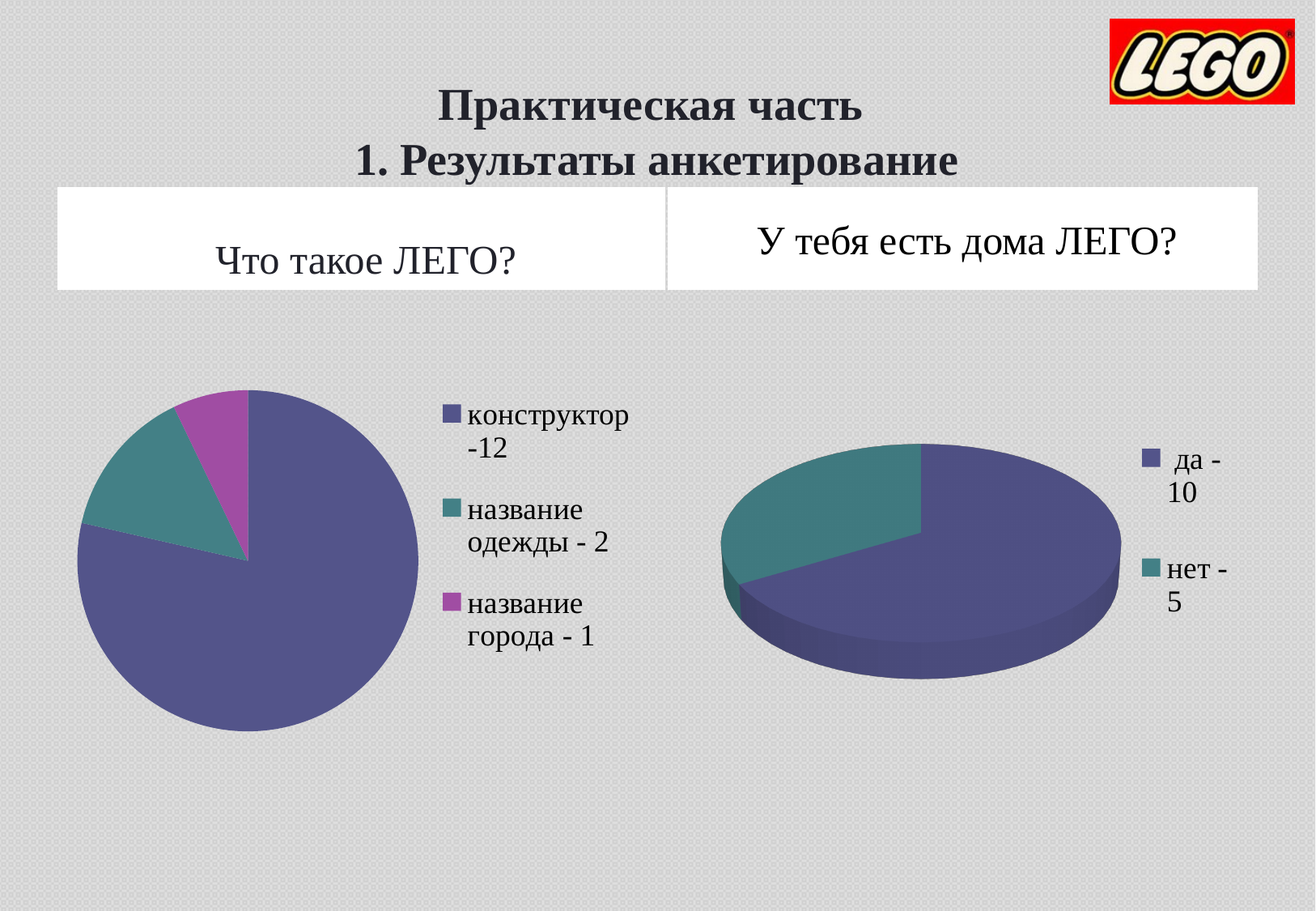
In the "Что такое ЛЕГО?" chart, how many categories are shown? 3 In the "Что такое ЛЕГО?" chart, what share of the total does "конструктор" represent? 80% In the "Что такое ЛЕГО?" chart, how many respondents answered "название одежды"? 2 In the "Что такое ЛЕГО?" chart, which category has the smallest slice? название города In the "Что такое ЛЕГО?" chart, what colour is the "название города" slice? purple In the "У тебя есть дома ЛЕГО?" chart, how many respondents answered "да"? 10 In the "У тебя есть дома ЛЕГО?" chart, what is the difference between "да" and "нет"? 5 What kind of chart is used for "Что такое ЛЕГО?"? pie chart In the "Что такое ЛЕГО?" chart, which category has the largest slice? конструктор In the "Что такое ЛЕГО?" chart, what is the difference between "конструктор" and "название одежды"? 10 In the "Что такое ЛЕГО?" chart, how many respondents answered "конструктор"? 12 In the "У тебя есть дома ЛЕГО?" chart, which answer is larger, "да" or "нет"? да